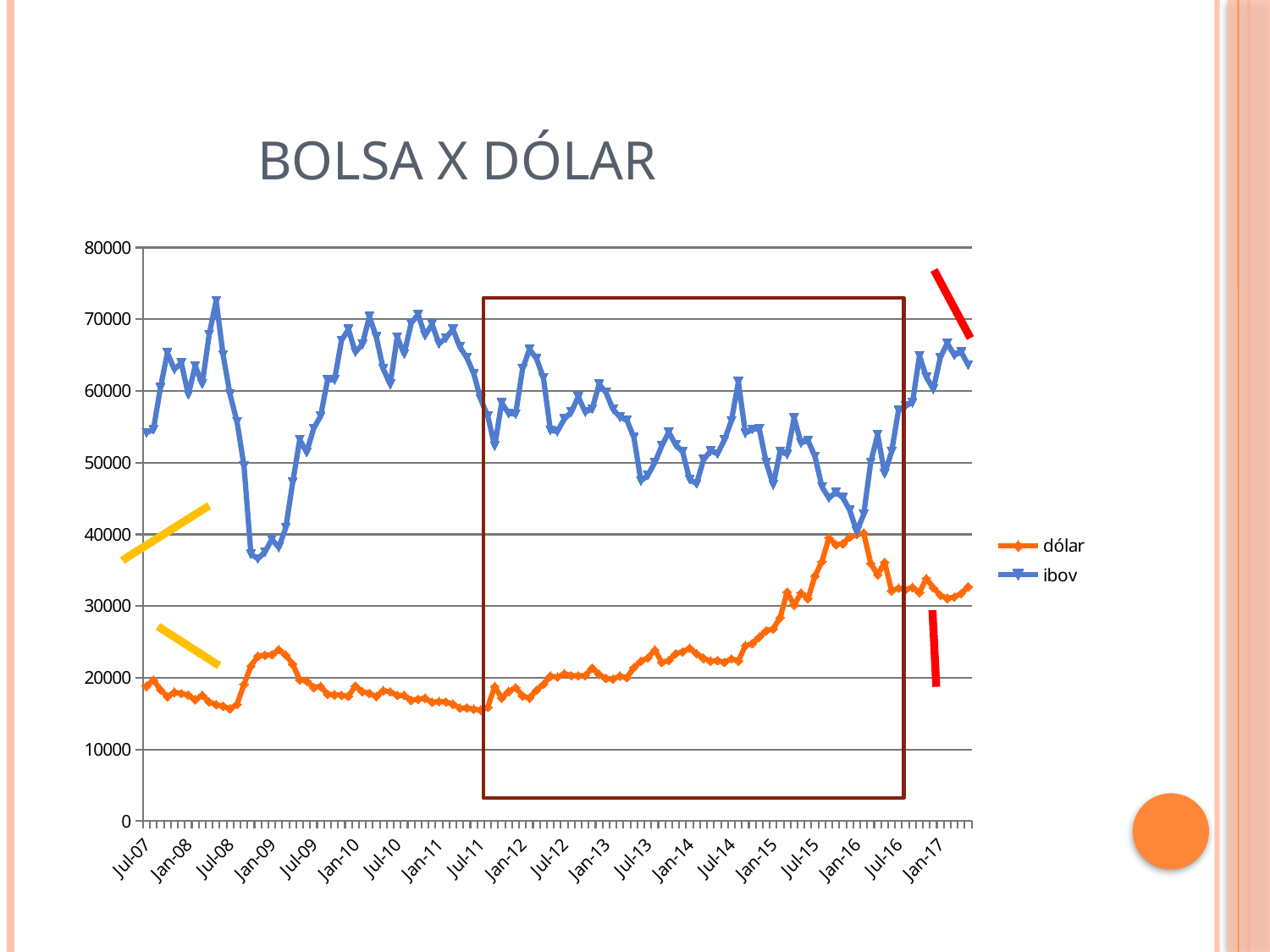
Is the value of ibov at Jul-07 greater or less than 50000? greater Does the dólar series rise or fall between Jan-14 and Jan-16? rise At Jul-07, which series has the larger value, dólar or ibov? ibov What is the title of the slide above the chart? BOLSA X DÓLAR How many series does the legend list? 2 What are the two series named in the legend? dólar and ibov Does the ibov series rise or fall overall between Jan-11 and Jan-16? fall Is the value of dólar at Jan-16 greater or less than 30000? greater What kind of chart is shown on the slide? line chart Is the value of dólar at Jul-07 greater or less than 30000? less